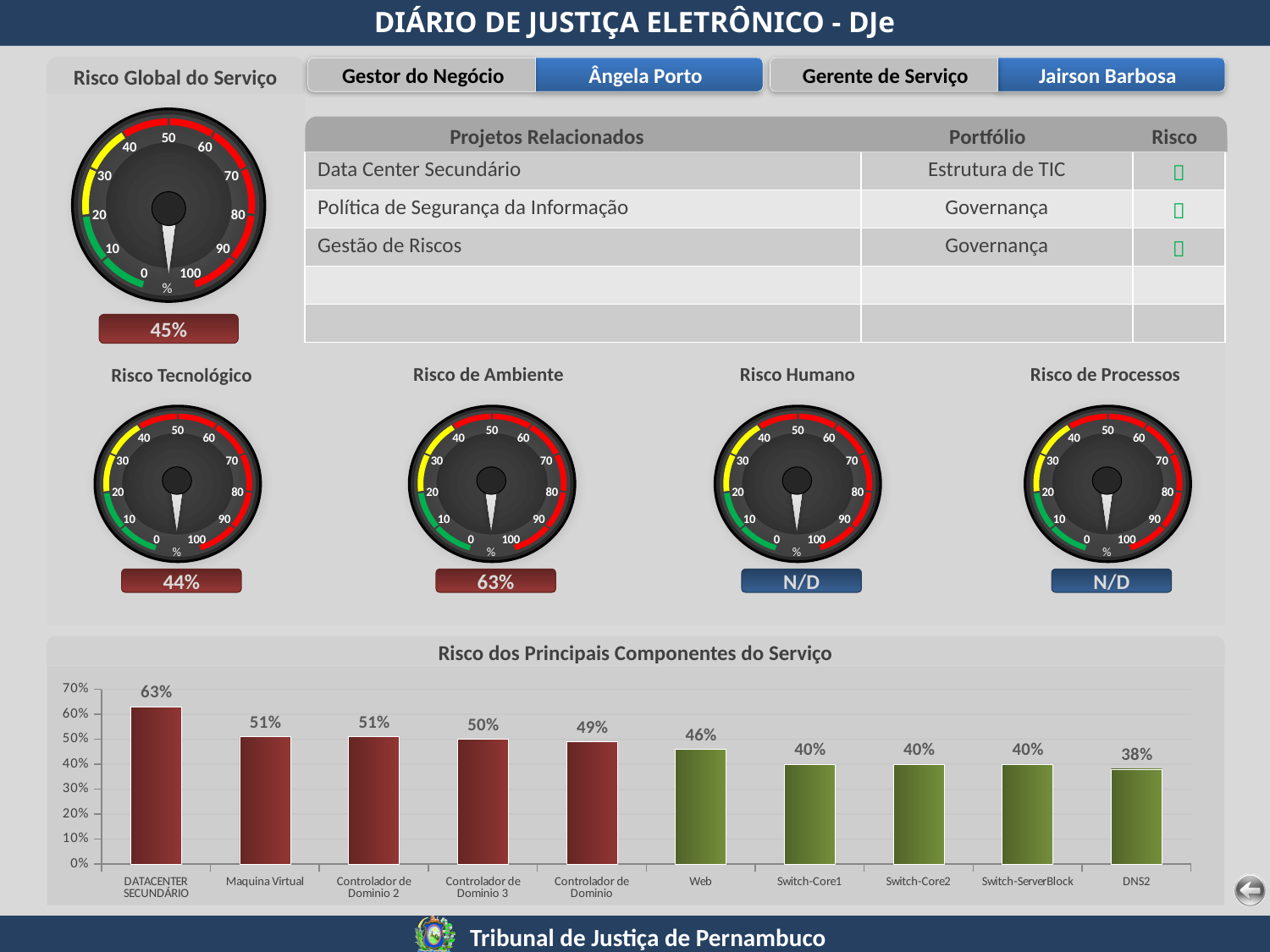
In the 'Risco dos Principais Componentes do Serviço' chart, how many categories are shown? 10 What value does the 'Risco de Ambiente' gauge show? 63% In the 'Risco dos Principais Componentes do Serviço' chart, what is the value for DATACENTER SECUNDÁRIO? 63% In the 'Risco dos Principais Componentes do Serviço' chart, what is the difference between DATACENTER SECUNDÁRIO and Web? 17% What kind of chart is 'Risco dos Principais Componentes do Serviço'? Bar chart In the 'Risco dos Principais Componentes do Serviço' chart, which is larger: Controlador de Dominio 3 or Switch-Core1? Controlador de Dominio 3 In the 'Risco dos Principais Componentes do Serviço' chart, do the values rise or fall from left to right? Fall In the 'Risco dos Principais Componentes do Serviço' chart, what is the value for Web? 46% What value does the 'Risco Global do Serviço' gauge show? 45% In the 'Risco dos Principais Componentes do Serviço' chart, what is the value for DNS2? 38% In the 'Risco dos Principais Componentes do Serviço' chart, which category has the highest value? DATACENTER SECUNDÁRIO In the 'Risco dos Principais Componentes do Serviço' chart, which category has the lowest value? DNS2